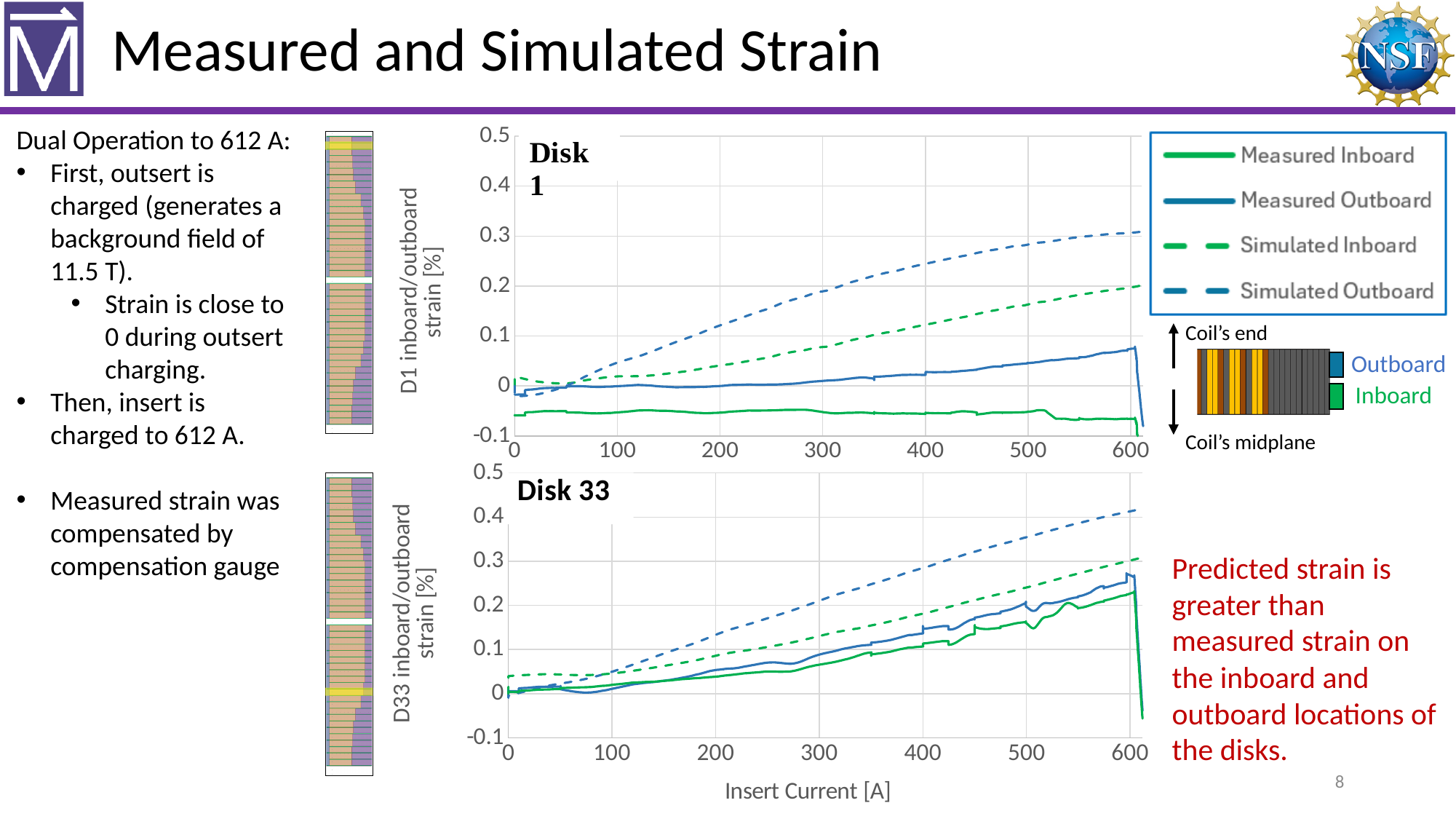
In the Disk 33 chart, does the Measured Outboard strain rise or fall as insert current increases from 0 to 600 A? rise In the Disk 1 chart, which series reaches the highest strain at 600 A? Simulated Outboard In the Disk 33 chart, is the Simulated Outboard strain at 500 A greater or less than 0.3? greater In the Disk 33 chart, is the Measured Outboard strain at 600 A greater or less than 0.2? greater In the Disk 1 chart, is the Simulated Outboard strain at 400 A greater or less than 0.2? greater What is the x-axis title shared by the two strain charts? Insert Current [A] What kind of chart is the Disk 1 chart? line chart In the Disk 1 chart, which series has the lowest strain values across the insert current range? Measured Inboard In the Disk 33 chart, which is larger at 400 A: the Simulated Outboard strain or the Measured Outboard strain? Simulated Outboard How many series does the legend list for the strain charts? 4